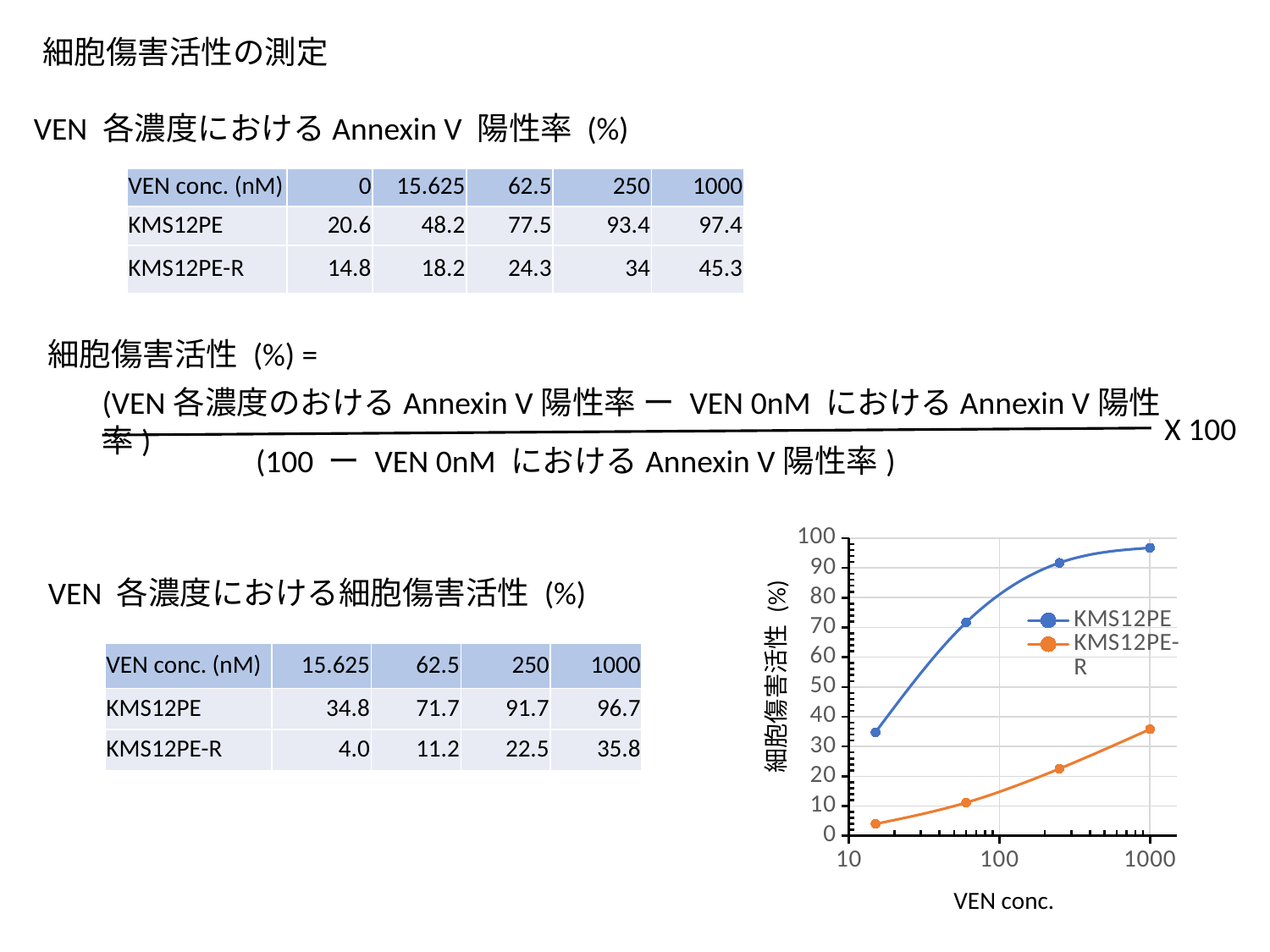
How many series does the chart's legend list? 2 At VEN conc. 1000 nM, which series has the higher 細胞傷害活性 value, KMS12PE or KMS12PE-R? KMS12PE Is the 細胞傷害活性 value for KMS12PE-R at VEN conc. 1000 nM greater or less than 40? less Using the 細胞傷害活性 table values, what is the difference between KMS12PE and KMS12PE-R at VEN conc. 1000 nM? 60.9 What is the title of the chart's y-axis? 細胞傷害活性 (%) How many data points are plotted for the KMS12PE series? 4 What type of chart is shown on the slide? line chart Is the 細胞傷害活性 value for KMS12PE at VEN conc. 62.5 nM greater or less than 60? greater What are the two series named in the chart's legend? KMS12PE and KMS12PE-R According to the 細胞傷害活性 table, what is the value for KMS12PE at VEN conc. 1000 nM? 96.7 Do the values for KMS12PE-R rise or fall as VEN conc. increases along the x axis? rise Which series reaches the highest 細胞傷害活性 value on the chart? KMS12PE